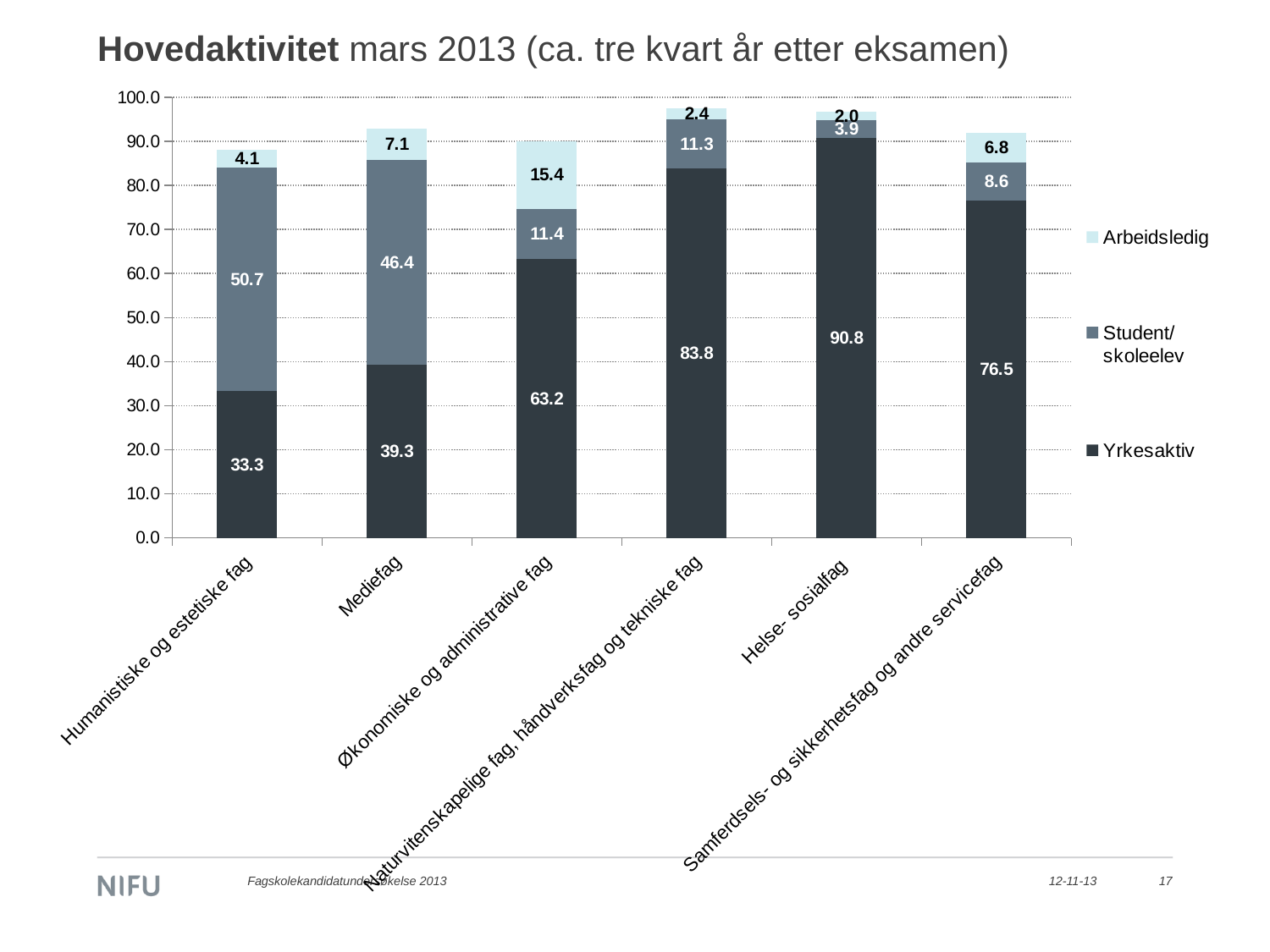
What is the Yrkesaktiv value for Helse- sosialfag? 90.8 What kind of chart is shown on the slide? Stacked bar chart How many categories are shown on the x axis? 6 Which is larger: the Arbeidsledig value for Mediefag or for Samferdsels- og sikkerhetsfag og andre servicefag? Mediefag What is the Arbeidsledig value for Økonomiske og administrative fag? 15.4 Which category has the lowest Yrkesaktiv value? Humanistiske og estetiske fag What is the difference between the Yrkesaktiv values for Naturvitenskapelige fag, håndverksfag og tekniske fag and Mediefag? 44.5 Which series is shown in the lightest colour in the legend? Arbeidsledig What is the total of the stacked bar for Humanistiske og estetiske fag? 88.1 What is the Student/skoleelev value for Mediefag? 46.4 Which category has the highest Yrkesaktiv value? Helse- sosialfag How many series does the legend list? 3